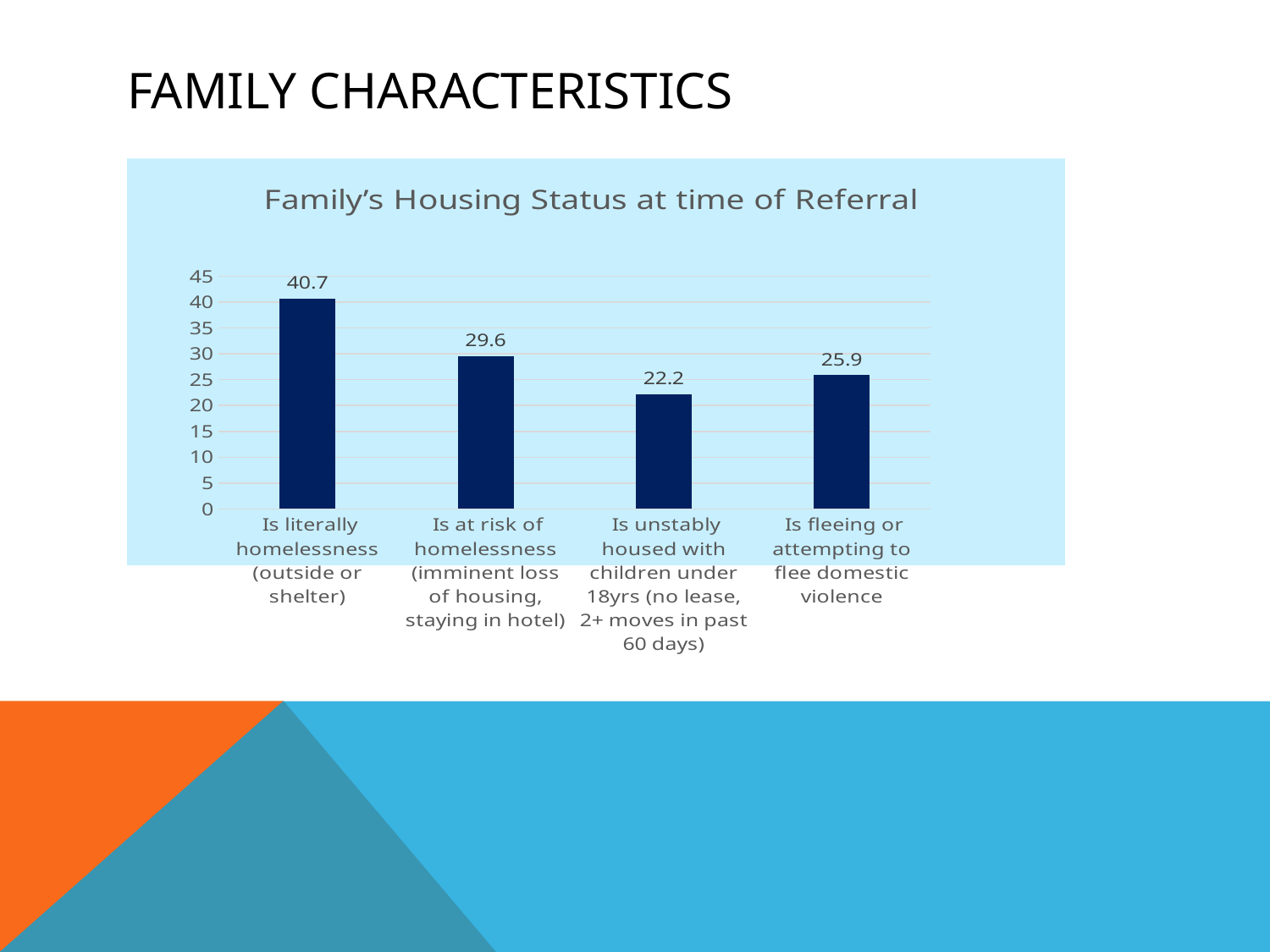
What is the title of the chart? Family's Housing Status at time of Referral What is the value for 'Is literally homelessness (outside or shelter)'? 40.7 What is the difference between the values for 'Is literally homelessness' and 'Is at risk of homelessness'? 11.1 What is the value for 'Is fleeing or attempting to flee domestic violence'? 25.9 What is the value for 'Is unstably housed with children under 18yrs'? 22.2 How many categories are shown in the chart? 4 Which is larger: the value for 'Is fleeing or attempting to flee domestic violence' or the value for 'Is unstably housed with children under 18yrs'? Is fleeing or attempting to flee domestic violence Is the value for 'Is at risk of homelessness' greater or less than 25? greater Which category has the lowest value? Is unstably housed with children under 18yrs (no lease, 2+ moves in past 60 days) Which category has the highest value? Is literally homelessness (outside or shelter) What is the value for 'Is at risk of homelessness (imminent loss of housing, staying in hotel)'? 29.6 What kind of chart is shown on the slide? Bar chart